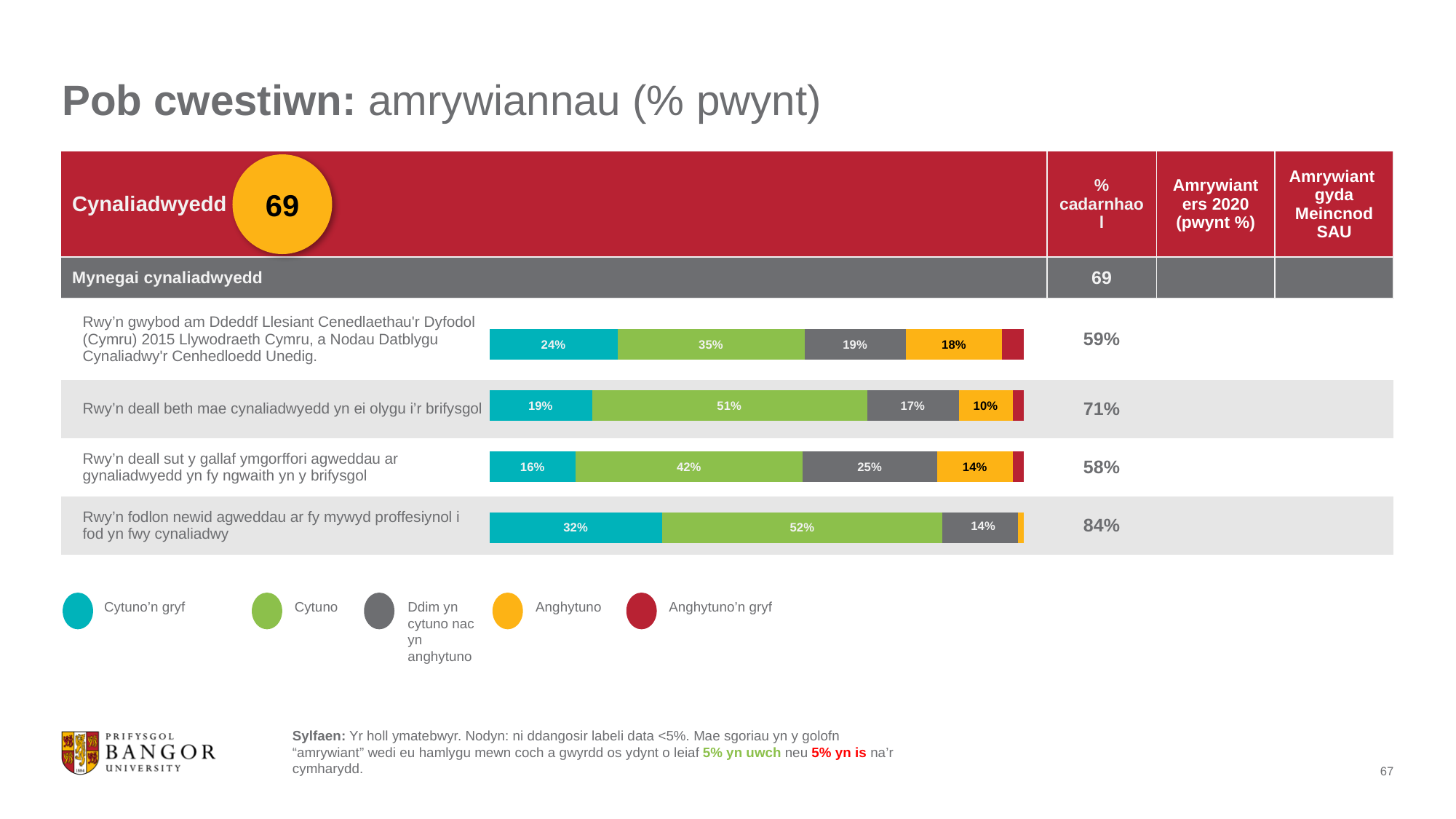
What kind of chart is shown on the slide? stacked bar chart How many response categories does the legend list? 5 Which statement has the lowest Cytuno'n gryf value? Rwy'n deall sut y gallaf ymgorffori agweddau ar gynaliadwyedd yn fy ngwaith yn y brifysgol What is the Cytuno'n gryf value for 'Rwy'n fodlon newid agweddau ar fy mywyd proffesiynol i fod yn fwy cynaliadwy'? 32% What is the Cytuno value for 'Rwy'n deall beth mae cynaliadwyedd yn ei olygu i'r brifysgol'? 51% What is the difference between the Cytuno values for 'Rwy'n fodlon newid agweddau ar fy mywyd proffesiynol' and 'Rwy'n gwybod am Ddeddf Llesiant Cenedlaethau'r Dyfodol'? 17% What is the % cadarnhaol for 'Rwy'n gwybod am Ddeddf Llesiant Cenedlaethau'r Dyfodol (Cymru) 2015'? 59% How many statements (bars) are plotted in the chart? 4 Which is larger: the Ddim yn cytuno nac yn anghytuno value for 'Rwy'n deall sut y gallaf ymgorffori agweddau' or for 'Rwy'n deall beth mae cynaliadwyedd yn ei olygu i'r brifysgol'? Rwy'n deall sut y gallaf ymgorffori agweddau Which statement has the highest % cadarnhaol? Rwy'n fodlon newid agweddau ar fy mywyd proffesiynol i fod yn fwy cynaliadwy What is the Anghytuno value for 'Rwy'n deall sut y gallaf ymgorffori agweddau ar gynaliadwyedd yn fy ngwaith yn y brifysgol'? 14% What is the value shown in the orange circle next to 'Cynaliadwyedd' in the header? 69